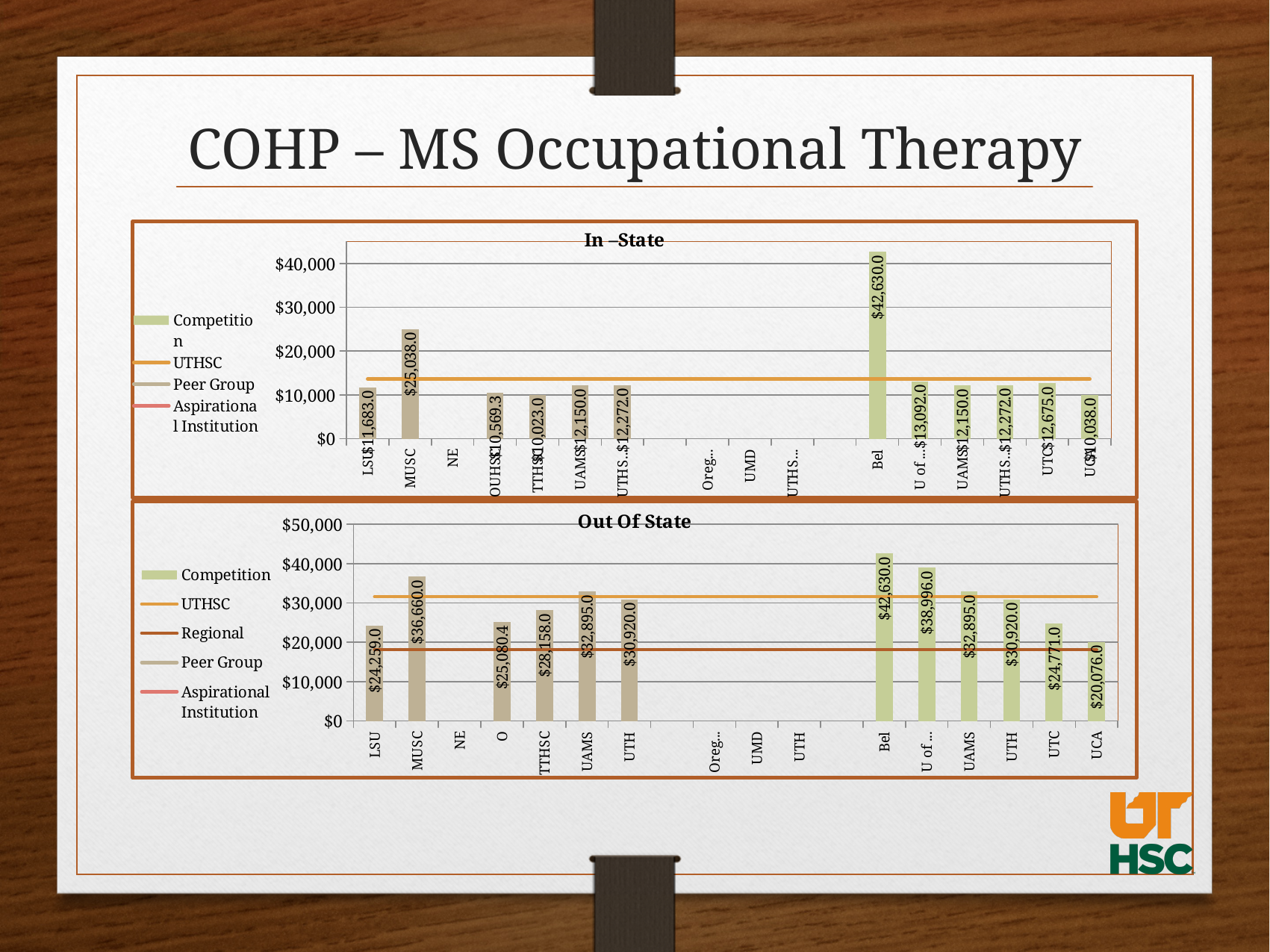
On the In-State chart, what is the value for MUSC? $25,038.0 On the Out Of State chart, what is the value for UTC? $24,771.0 On the In-State chart, which institution has the highest value? Bel On the In-State chart, what is the difference between the MUSC value and the LSU value? $13,355.0 On the Out Of State chart, what is the value for MUSC? $36,660.0 How many entries does the legend of the Out Of State chart list? 5 On the Out Of State chart, which institution has the lowest value? UCA On the Out Of State chart, what is the difference between the Bel value and the MUSC value? $5,970.0 On the Out Of State chart, is the value for TTHSC greater or less than $30,000? less On the In-State chart, what is the value for Bel? $42,630.0 How many entries does the legend of the In-State chart list? 4 On the In-State chart, which is larger, the value for MUSC or the value for LSU? MUSC